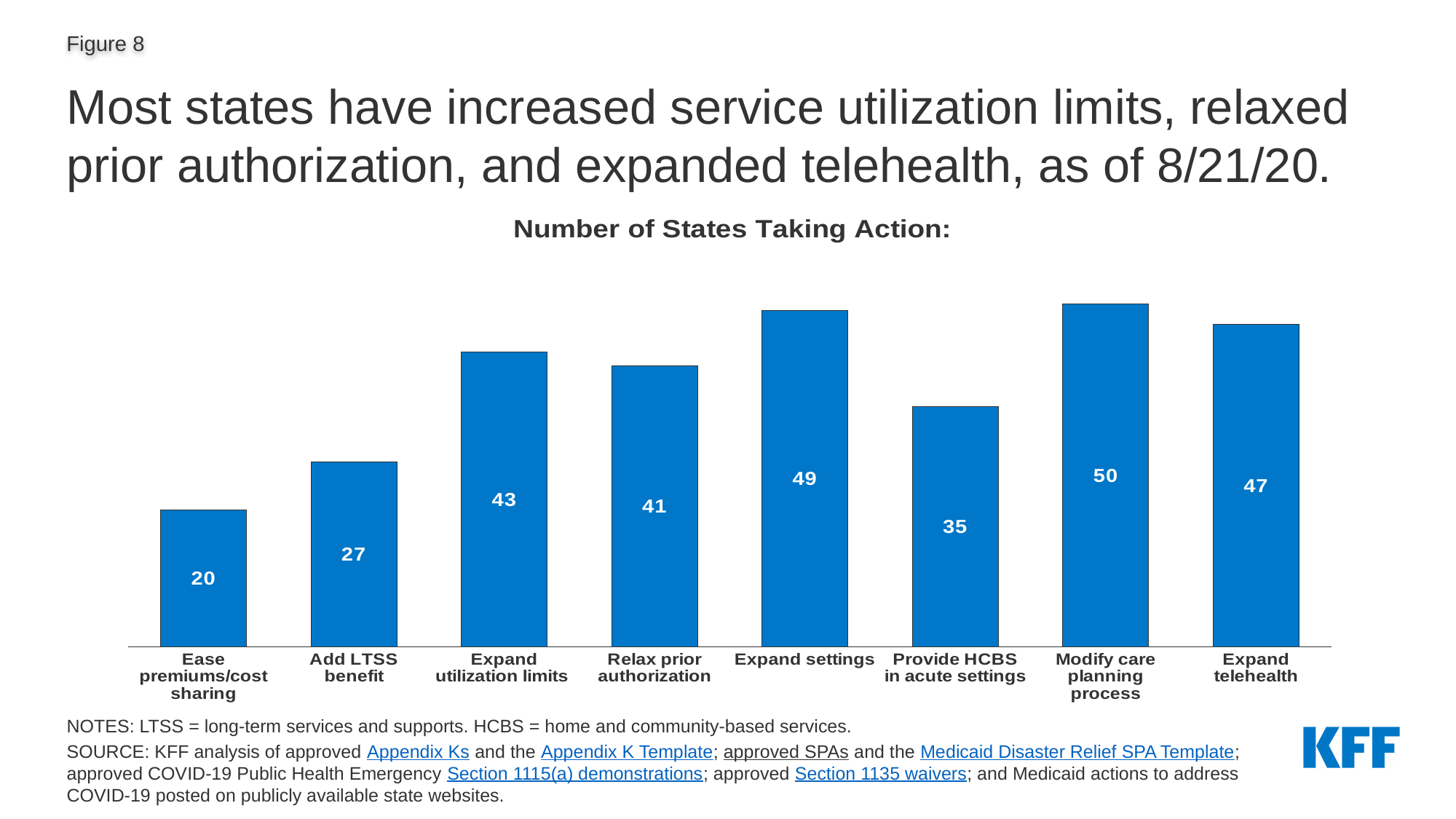
What is the title of the chart? Number of States Taking Action: What is the difference between the number of states that expanded utilization limits and the number that added an LTSS benefit? 16 Which action has been taken by the most states? Modify care planning process What type of chart is shown on the slide? Bar chart How many action categories are shown in the chart? 8 What colour are the bars in the chart? Blue What is the number of states that have eased premiums/cost sharing? 20 How many states have relaxed prior authorization? 41 How many states have taken action to expand telehealth? 47 How many more states have expanded settings than have provided HCBS in acute settings? 14 Which has more states taking action: Expand settings or Expand telehealth? Expand settings Which action has been taken by the fewest states? Ease premiums/cost sharing